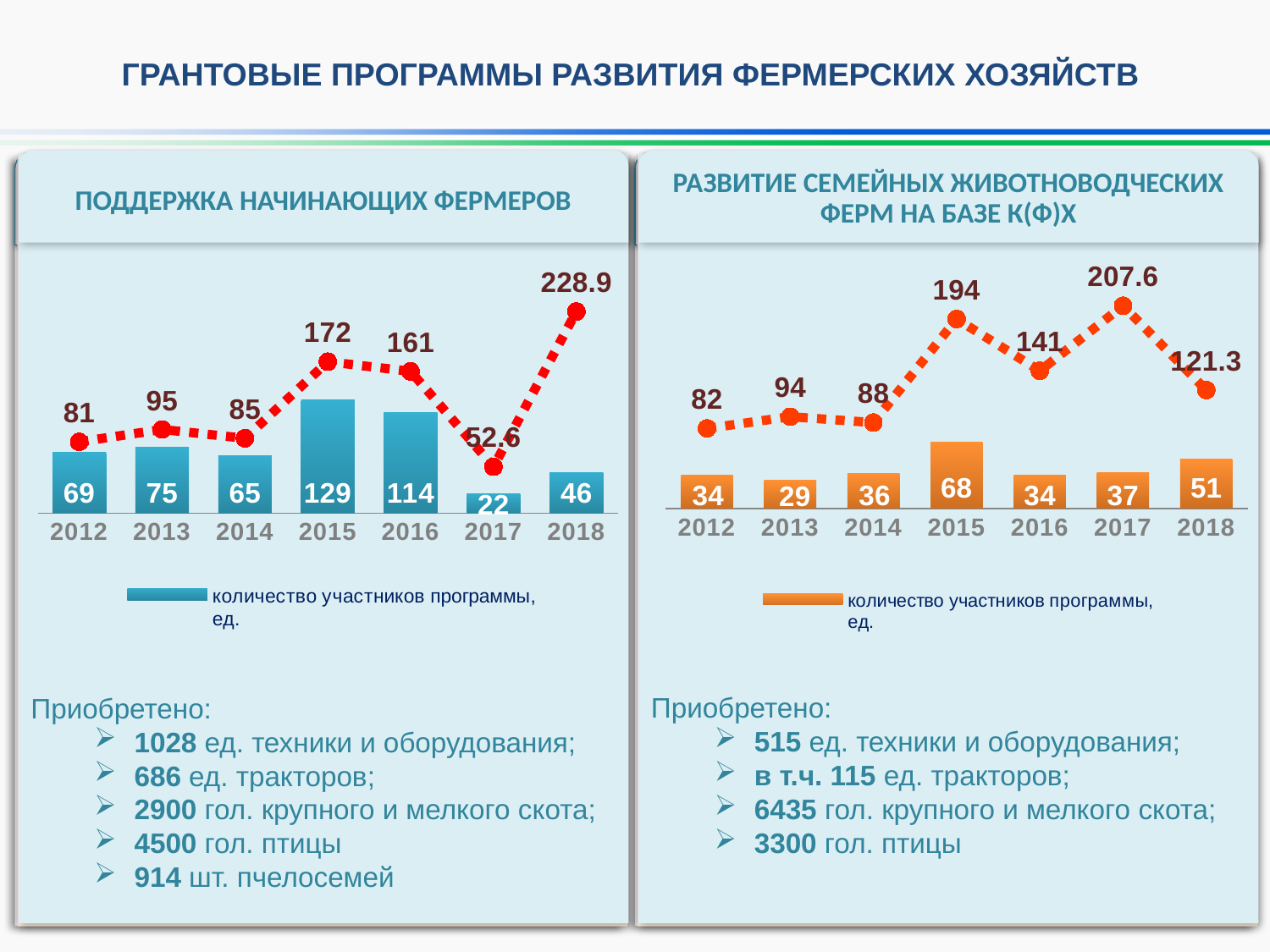
In the left chart (ПОДДЕРЖКА НАЧИНАЮЩИХ ФЕРМЕРОВ), what is the difference in program participants between 2015 and 2016? 15 In the left chart (ПОДДЕРЖКА НАЧИНАЮЩИХ ФЕРМЕРОВ), which year has the lowest number of program participants? 2017 In the left chart (ПОДДЕРЖКА НАЧИНАЮЩИХ ФЕРМЕРОВ), how many years are shown on the x axis? 7 In the right chart (РАЗВИТИЕ СЕМЕЙНЫХ ЖИВОТНОВОДЧЕСКИХ ФЕРМ), what is the difference in program participants between 2015 and 2013? 39 In the left chart (ПОДДЕРЖКА НАЧИНАЮЩИХ ФЕРМЕРОВ), how many program participants are shown for 2015? 129 In the right chart (РАЗВИТИЕ СЕМЕЙНЫХ ЖИВОТНОВОДЧЕСКИХ ФЕРМ), which year has the highest number of program participants? 2015 What does the legend entry under the right chart (РАЗВИТИЕ СЕМЕЙНЫХ ЖИВОТНОВОДЧЕСКИХ ФЕРМ) say? количество участников программы, ед. In the right chart (РАЗВИТИЕ СЕМЕЙНЫХ ЖИВОТНОВОДЧЕСКИХ ФЕРМ), is the red dotted line value for 2016 larger or smaller than for 2017? smaller In the right chart (РАЗВИТИЕ СЕМЕЙНЫХ ЖИВОТНОВОДЧЕСКИХ ФЕРМ), how many program participants are shown for 2018? 51 What type of chart is used in the left panel (ПОДДЕРЖКА НАЧИНАЮЩИХ ФЕРМЕРОВ)? Combined bar and line chart In the right chart (РАЗВИТИЕ СЕМЕЙНЫХ ЖИВОТНОВОДЧЕСКИХ ФЕРМ), what is the highest value on the red dotted line? 207.6 In the left chart (ПОДДЕРЖКА НАЧИНАЮЩИХ ФЕРМЕРОВ), what value does the red dotted line show for 2018? 228.9